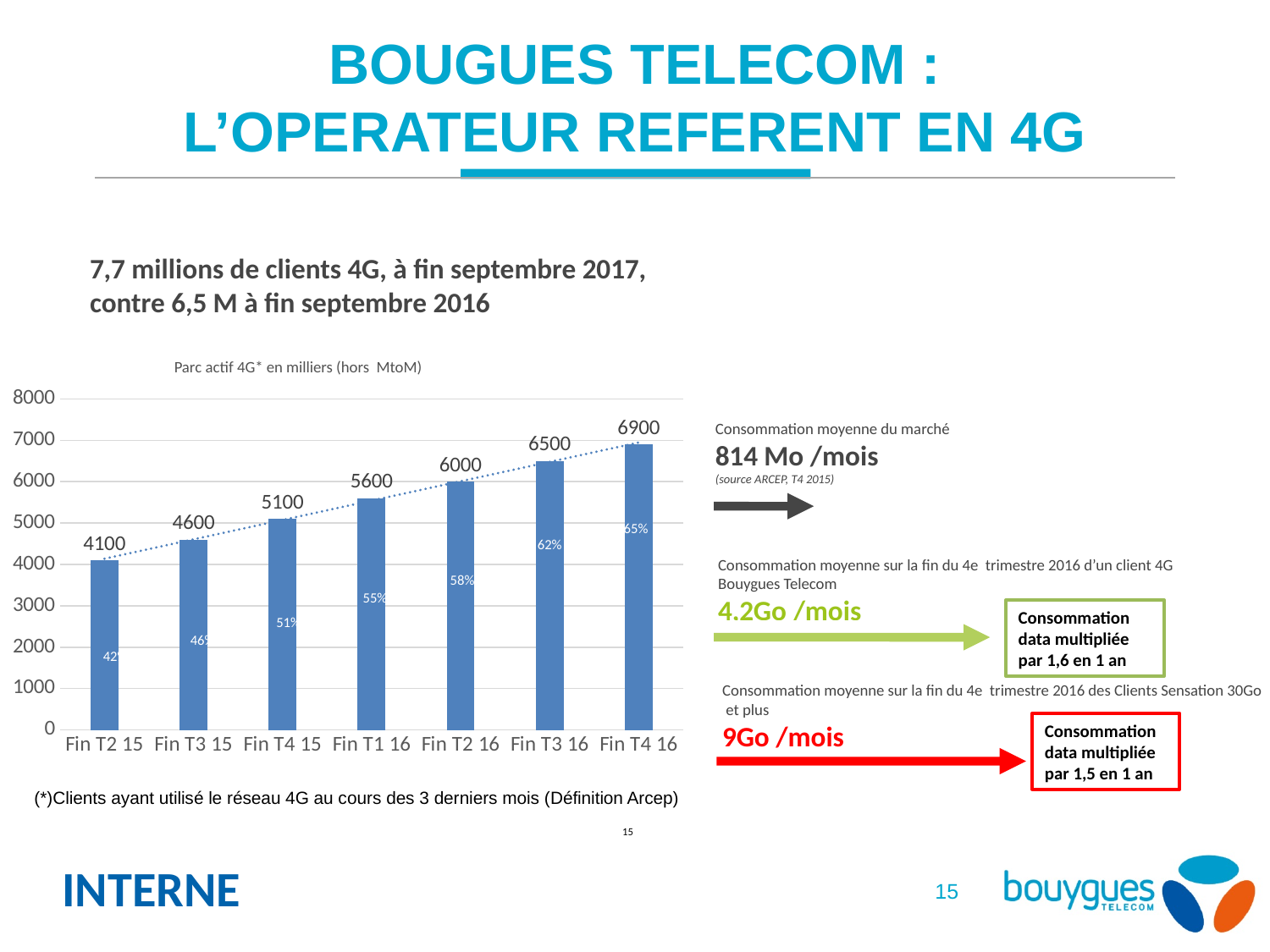
What is the value for Fin T1 16 in the 'Parc actif 4G* en milliers (hors MtoM)' chart? 5600 What is the difference between the values for Fin T3 16 and Fin T2 16 in the 'Parc actif 4G* en milliers (hors MtoM)' chart? 500 What is the value for Fin T2 15 in the 'Parc actif 4G* en milliers (hors MtoM)' chart? 4100 Which category has the highest value in the 'Parc actif 4G* en milliers (hors MtoM)' chart? Fin T4 16 What is the value for Fin T4 16 in the 'Parc actif 4G* en milliers (hors MtoM)' chart? 6900 In the 'Parc actif 4G* en milliers (hors MtoM)' chart, which is larger: the value for Fin T4 15 or the value for Fin T3 15? Fin T4 15 Do the values in the 'Parc actif 4G* en milliers (hors MtoM)' chart rise or fall from Fin T2 15 to Fin T4 16? Rise How many categories are shown on the x axis of the 'Parc actif 4G* en milliers (hors MtoM)' chart? 7 Which category has the lowest value in the 'Parc actif 4G* en milliers (hors MtoM)' chart? Fin T2 15 What is the difference between the values for Fin T4 16 and Fin T2 15 in the 'Parc actif 4G* en milliers (hors MtoM)' chart? 2800 What percentage label is printed inside the Fin T3 16 bar in the 'Parc actif 4G* en milliers (hors MtoM)' chart? 62% What kind of chart is the 'Parc actif 4G* en milliers (hors MtoM)' chart? Bar chart